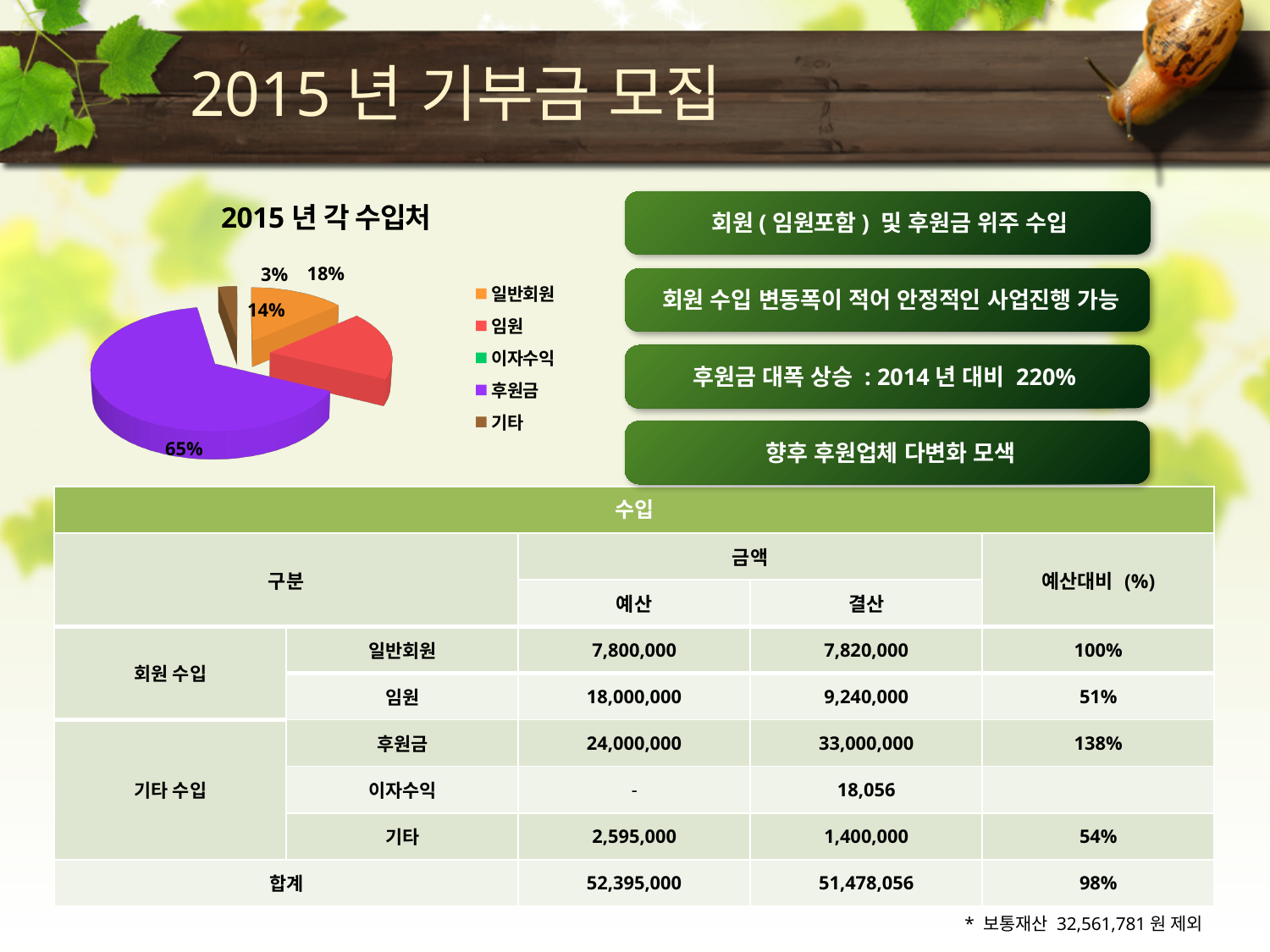
What kind of chart is shown on the slide? pie chart What is the title of the pie chart? 2015 년 각 수입처 Which category has the largest slice in the pie chart? 후원금 Which legend entry of the pie chart is listed first? 일반회원 Which is larger in the pie chart, 후원금 or 기타? 후원금 How many categories does the pie chart's legend list? 5 What percentage is shown for 기타 in the pie chart? 3% What is the difference in percentage points between the 후원금 slice (65%) and the 기타 slice (3%)? 62% What share of the pie does 후원금 account for? 65% What colour is used for 후원금 in the pie chart? purple